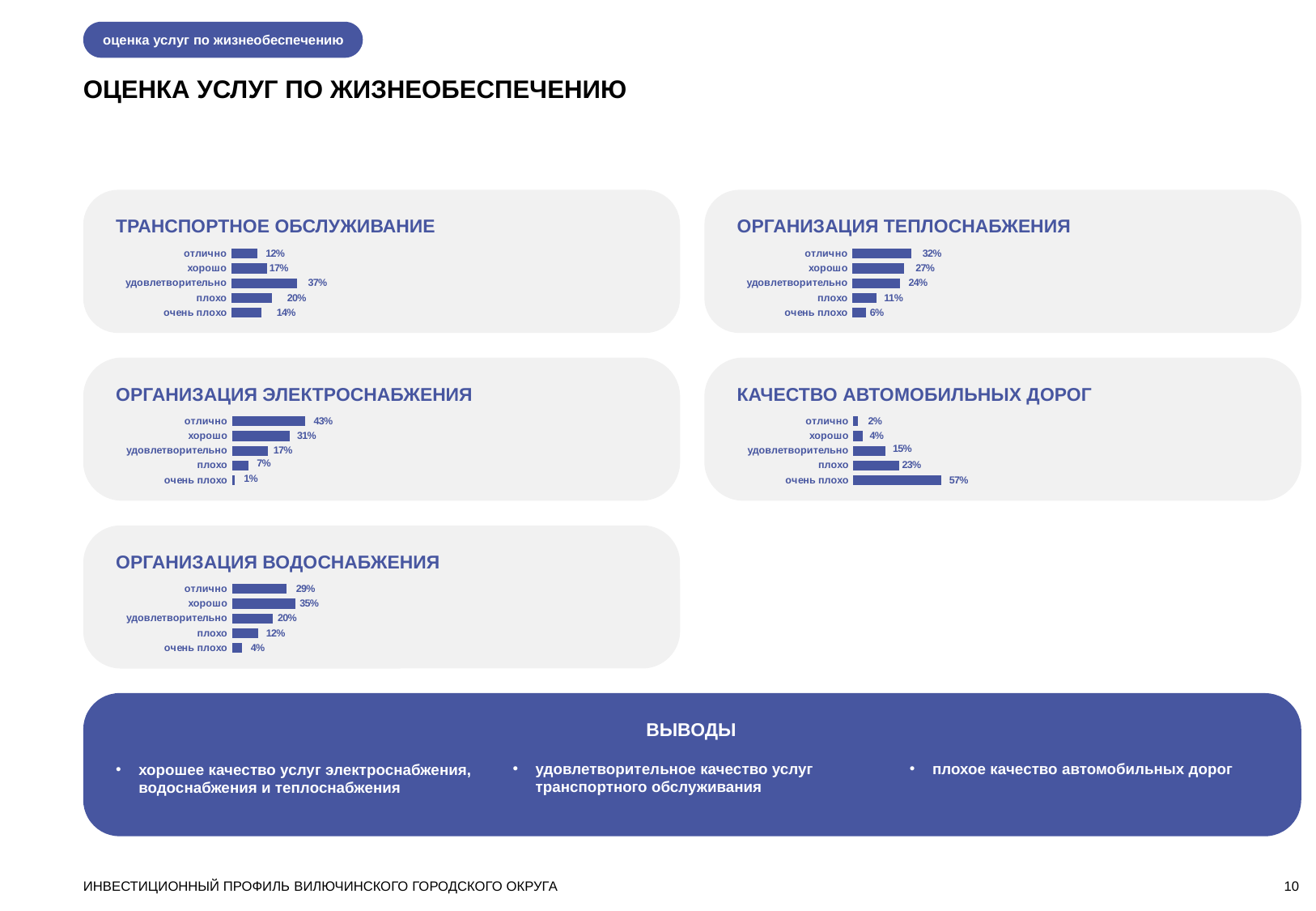
How many categories are shown in the 'КАЧЕСТВО АВТОМОБИЛЬНЫХ ДОРОГ' chart? 5 In the 'ОРГАНИЗАЦИЯ ТЕПЛОСНАБЖЕНИЯ' chart, what is the value for 'очень плохо'? 6% In the 'ТРАНСПОРТНОЕ ОБСЛУЖИВАНИЕ' chart, what is the value for 'удовлетворительно'? 37% In the 'ОРГАНИЗАЦИЯ ВОДОСНАБЖЕНИЯ' chart, what is the value for 'плохо'? 12% In the 'КАЧЕСТВО АВТОМОБИЛЬНЫХ ДОРОГ' chart, what is the value for 'очень плохо'? 57% In the 'ТРАНСПОРТНОЕ ОБСЛУЖИВАНИЕ' chart, which is larger: 'плохо' or 'очень плохо'? плохо In the 'ОРГАНИЗАЦИЯ ЭЛЕКТРОСНАБЖЕНИЯ' chart, do the values rise or fall going from 'отлично' to 'очень плохо'? fall In the 'КАЧЕСТВО АВТОМОБИЛЬНЫХ ДОРОГ' chart, which category has the lowest value? отлично In the 'ОРГАНИЗАЦИЯ ВОДОСНАБЖЕНИЯ' chart, what is the difference between 'хорошо' and 'отлично'? 6% In the 'ОРГАНИЗАЦИЯ ЭЛЕКТРОСНАБЖЕНИЯ' chart, which category has the highest value? отлично What kind of chart is used in the 'ОРГАНИЗАЦИЯ ТЕПЛОСНАБЖЕНИЯ' panel? bar chart How many bar charts are shown on the slide? 5